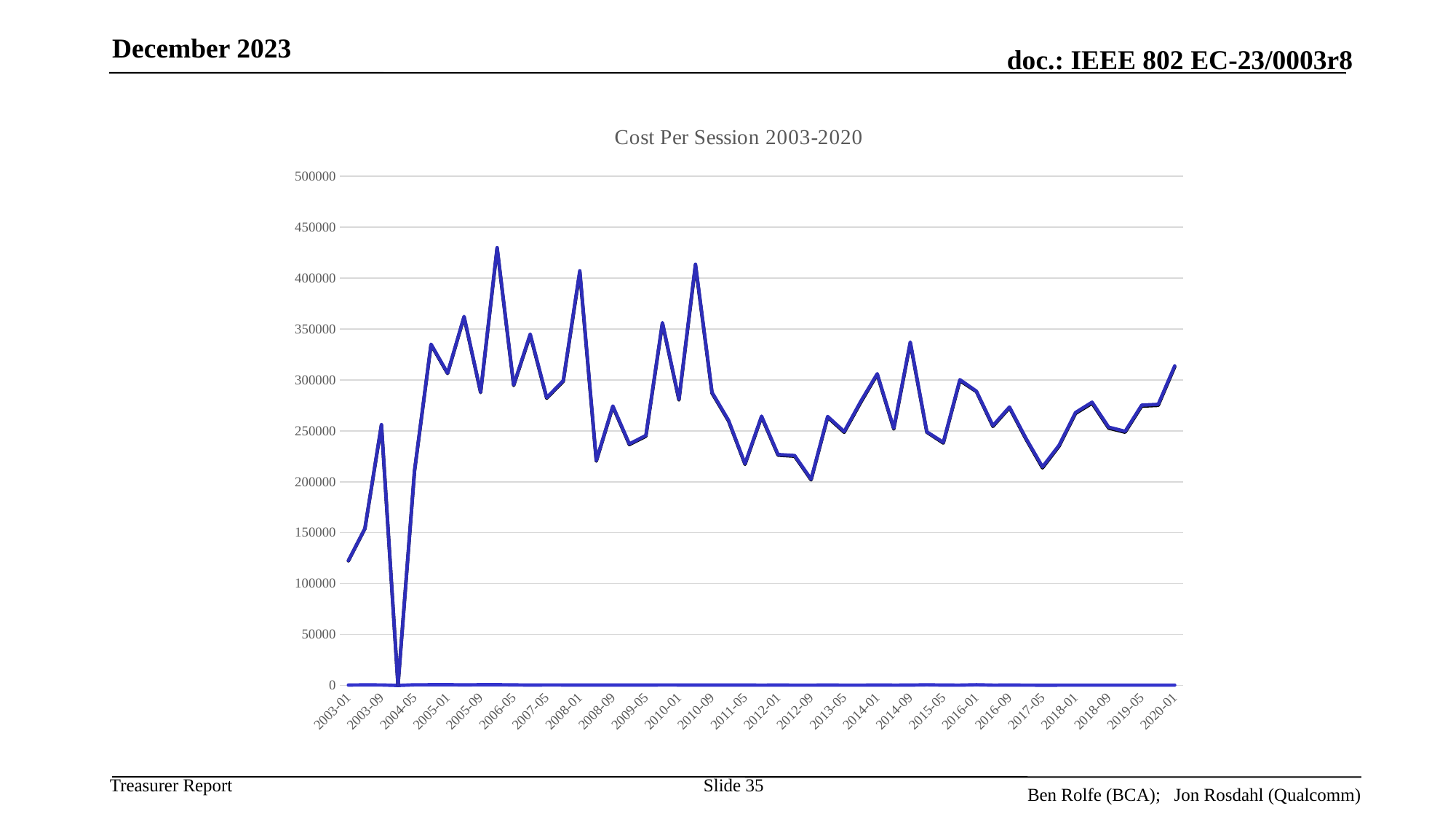
What kind of chart is shown on the slide? line chart Is the value for 2020-01 greater or less than 300000? greater Does the line rise or fall between 2003-01 and 2003-09? rise Is the highest value on the line greater or less than 400000? greater How many labels are shown on the horizontal axis? 26 Is the lowest value on the line greater or less than 50000? less What is the highest value shown on the vertical axis? 500000 Does the line rise or fall between 2019-05 and 2020-01? rise What is the title of the chart? Cost Per Session 2003-2020